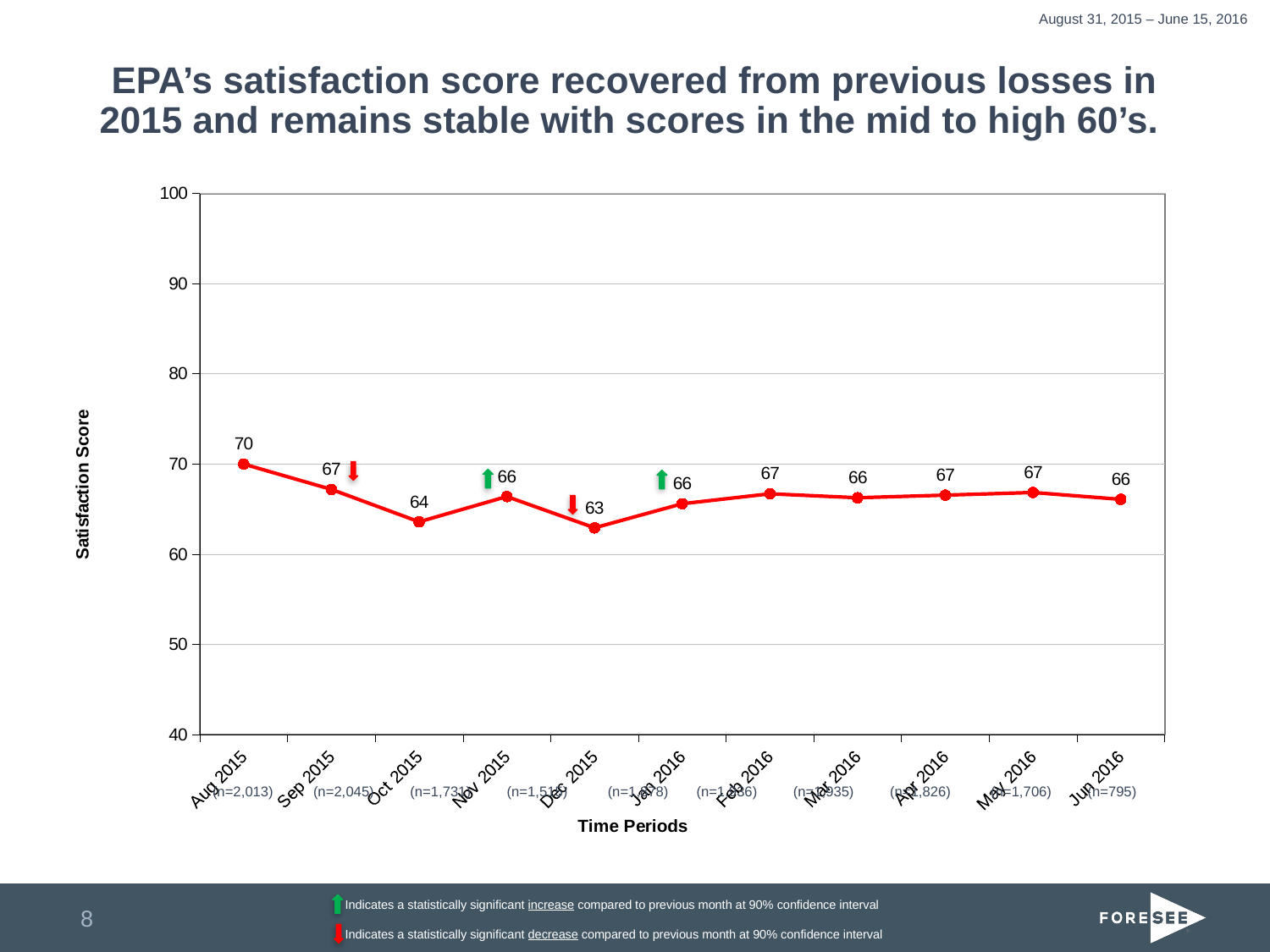
What is the satisfaction score for Dec 2015? 63 What is the satisfaction score for Jun 2016? 66 What is the satisfaction score for Oct 2015? 64 What is the satisfaction score for Aug 2015? 70 Which has a higher satisfaction score, Oct 2015 or Nov 2015? Nov 2015 What is the title of the vertical axis? Satisfaction Score Does the satisfaction score rise or fall from Aug 2015 to Oct 2015? Fall What is the difference between the satisfaction scores for Aug 2015 and Dec 2015? 7 Which time period has the lowest satisfaction score? Dec 2015 Which time period has the highest satisfaction score? Aug 2015 How many time periods are plotted on the chart? 11 What type of chart is shown on the slide? Line chart